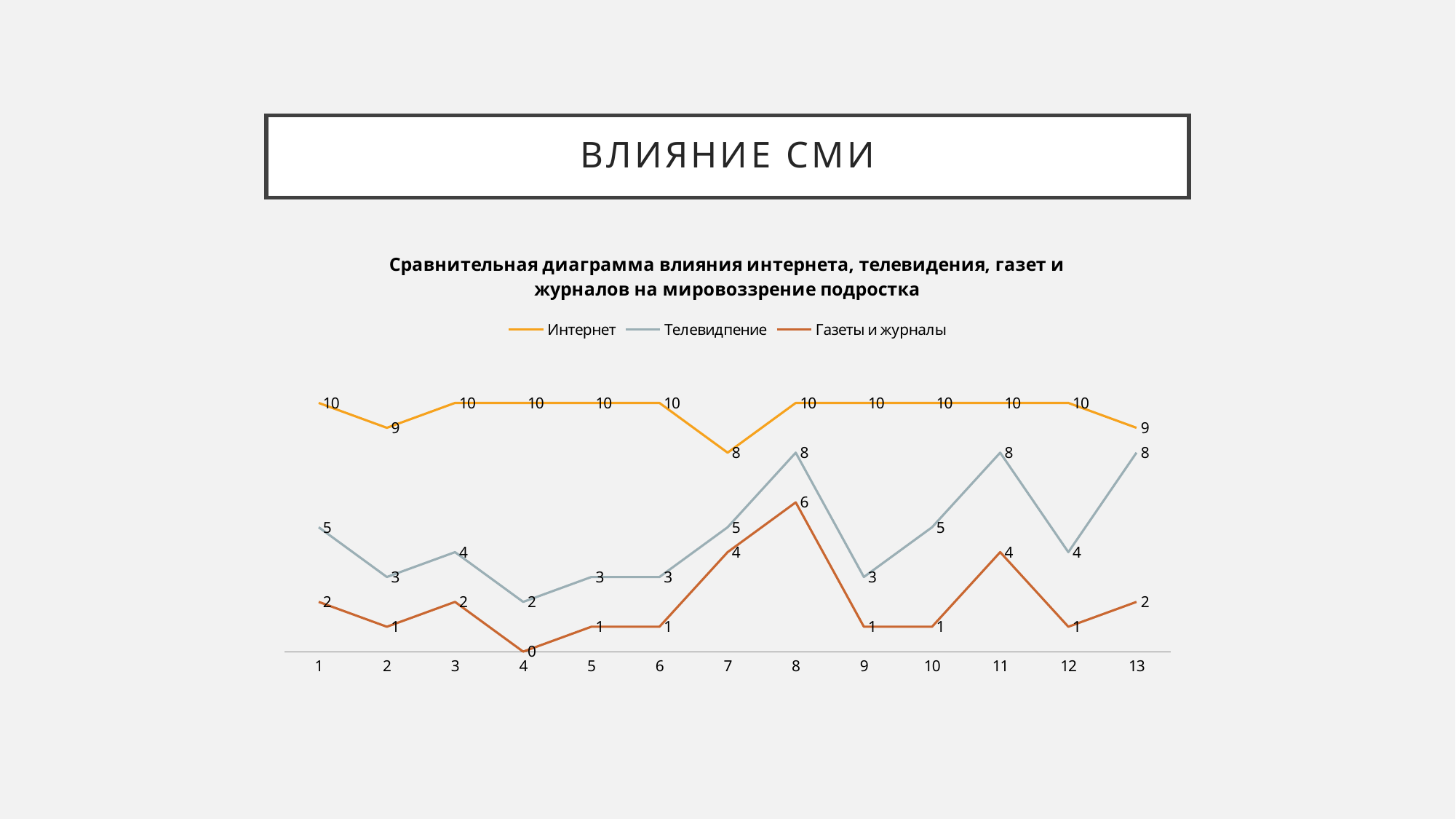
How many series does the legend list? 3 What is the difference between Интернет and Телевидпение at point 4? 8 What is the value for Газеты и журналы at point 4? 0 What is the value for Телевидпение at point 8? 8 At which point does Газеты и журналы reach its highest value? 8 What is the value for Газеты и журналы at point 8? 6 Which series has the larger value at point 12, Телевидпение or Газеты и журналы? Телевидпение What kind of chart is shown on the slide? Line chart How many points are plotted along the x axis? 13 At which point does Газеты и журналы reach its lowest value? 4 Which series is drawn in orange/yellow? Интернет What is the value for Интернет at point 7? 8